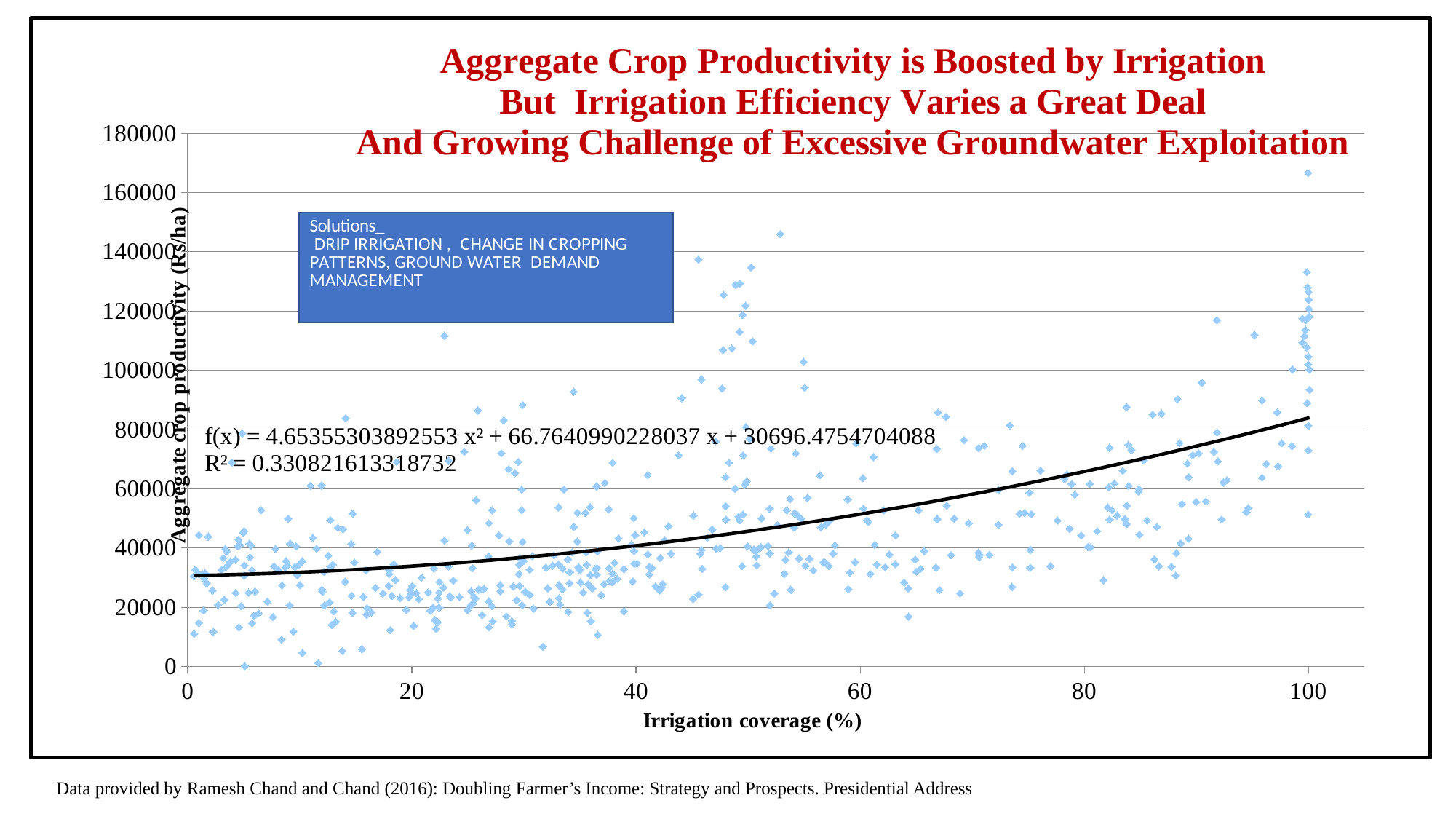
Is the aggregate crop productivity of the highest plotted point greater or less than 160000? greater What R² value is printed on the chart for the fitted trendline? 0.330821613318732 What kind of chart is shown on the slide? Scatter plot What is the label of the y axis? Aggregate crop productivity (Rs/ha) What is the label of the x axis? Irrigation coverage (%) Is the value of the fitted trendline at an irrigation coverage of 100% greater or less than 60000? greater Is the value of the fitted trendline at an irrigation coverage of 0% greater or less than 40000? less What is the highest tick value shown on the y axis? 180000 What is the highest tick value shown on the x axis? 100 What is the constant term in the fitted equation f(x) printed on the chart? 30696.4754704088 Does the fitted trendline rise or fall as irrigation coverage increases along the x axis? Rises